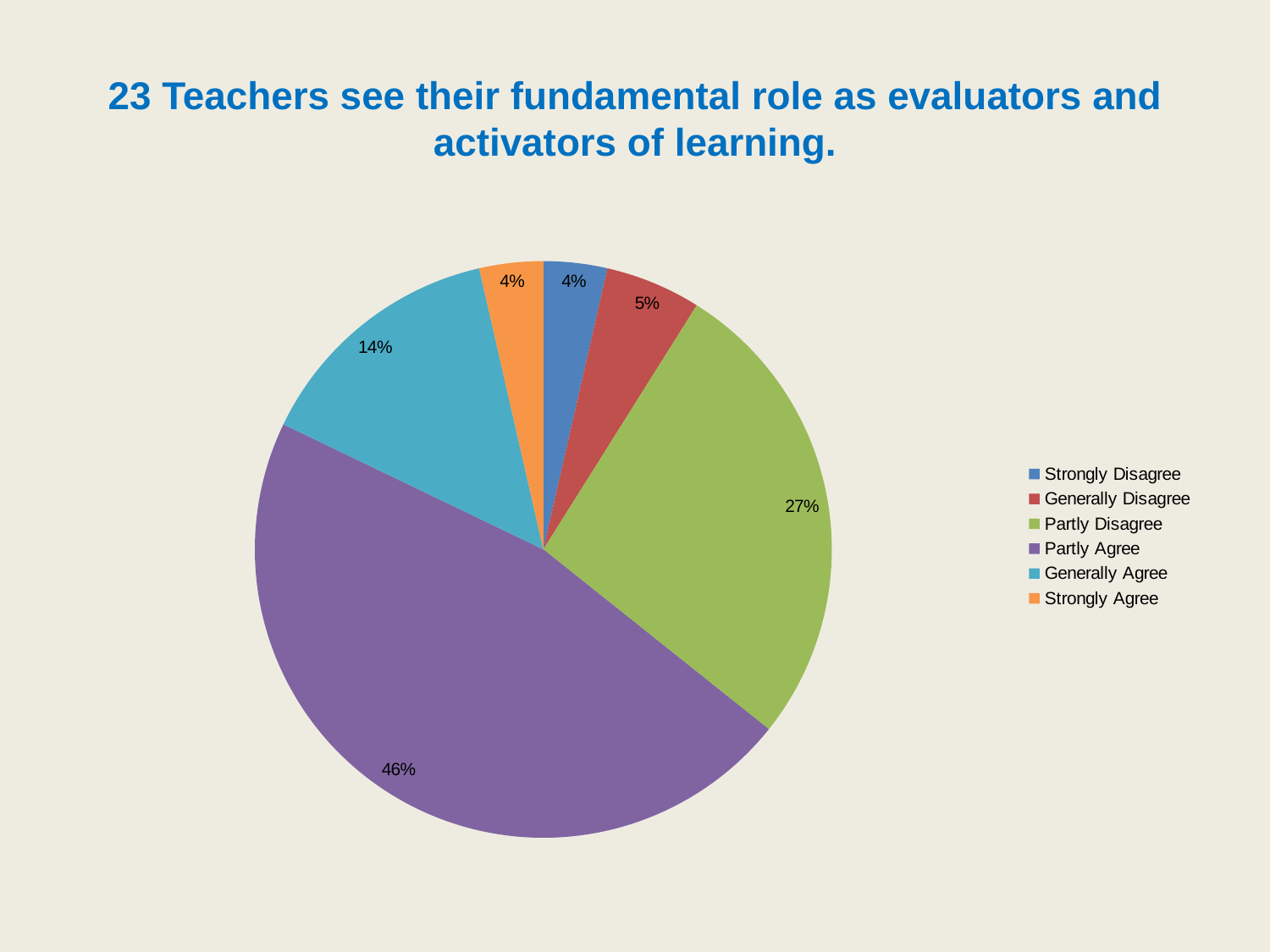
What percentage of respondents chose Partly Agree? 46% Which response category has the largest share of the pie? Partly Agree Which is larger, the share for Generally Agree or the share for Generally Disagree? Generally Agree What kind of chart is shown on the slide? pie chart What colour represents Partly Agree in the pie chart? purple What percentage of respondents chose Generally Disagree? 5% What is the difference in percentage points between Partly Agree and Partly Disagree? 19 How many response categories does the legend list? 6 What is the combined percentage for Partly Agree, Generally Agree and Strongly Agree? 64% What percentage of respondents chose Strongly Agree? 4% What percentage of respondents chose Partly Disagree? 27% What percentage of respondents chose Generally Agree? 14%